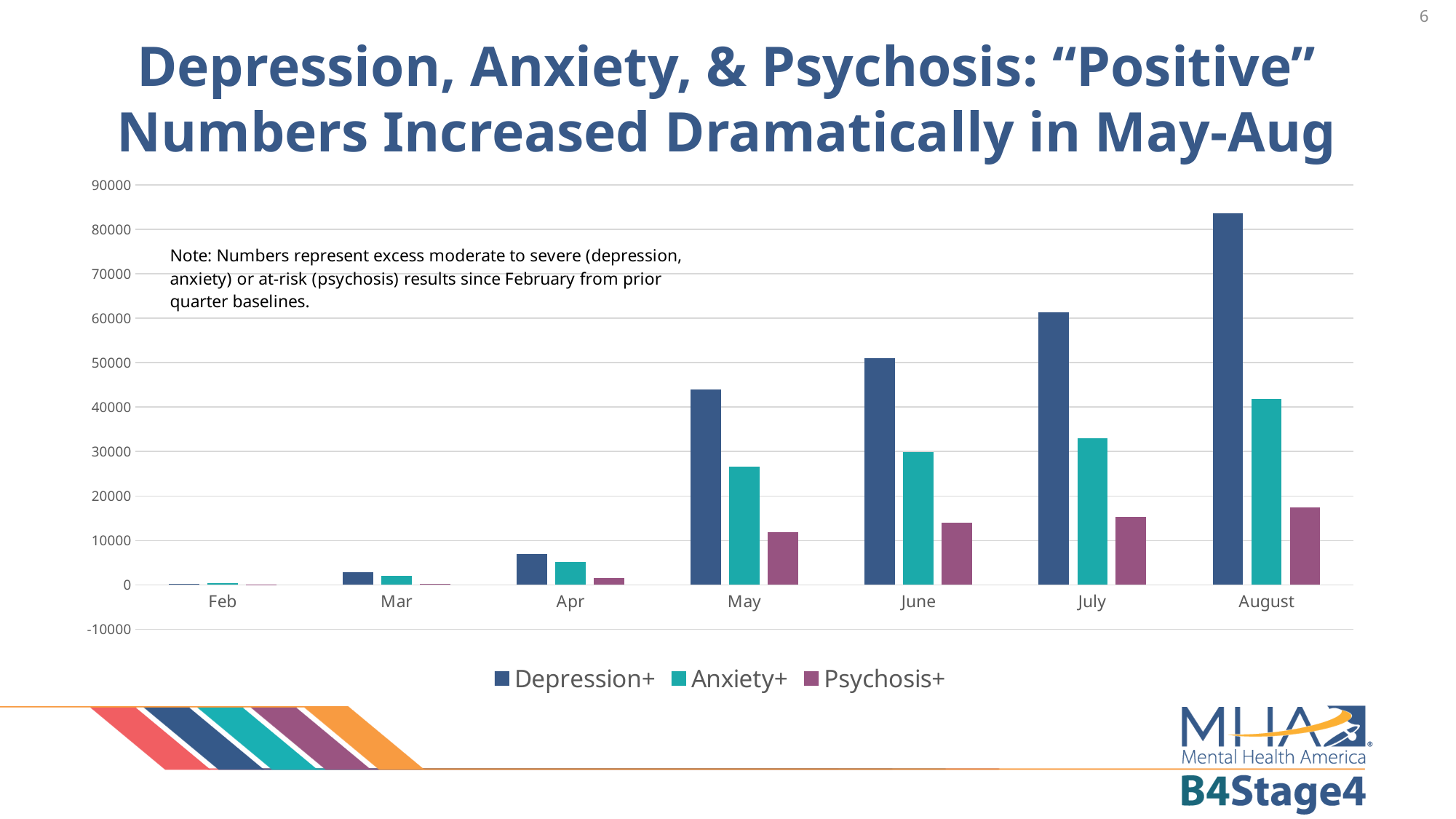
Which series is shown in purple? Psychosis+ Is the Psychosis+ value for August greater or less than 20000? less How many months are shown on the x axis? 7 Which is larger in July, the Depression+ value or the Anxiety+ value? Depression+ Is the Depression+ value for August greater or less than 80000? greater In which month is the Depression+ value highest? August Do the Depression+ values rise or fall from Feb to August? rise How many series does the legend list? 3 What kind of chart is shown on the slide? bar chart Is the Anxiety+ value for July greater or less than 30000? greater In which month is the Anxiety+ value lowest? Feb